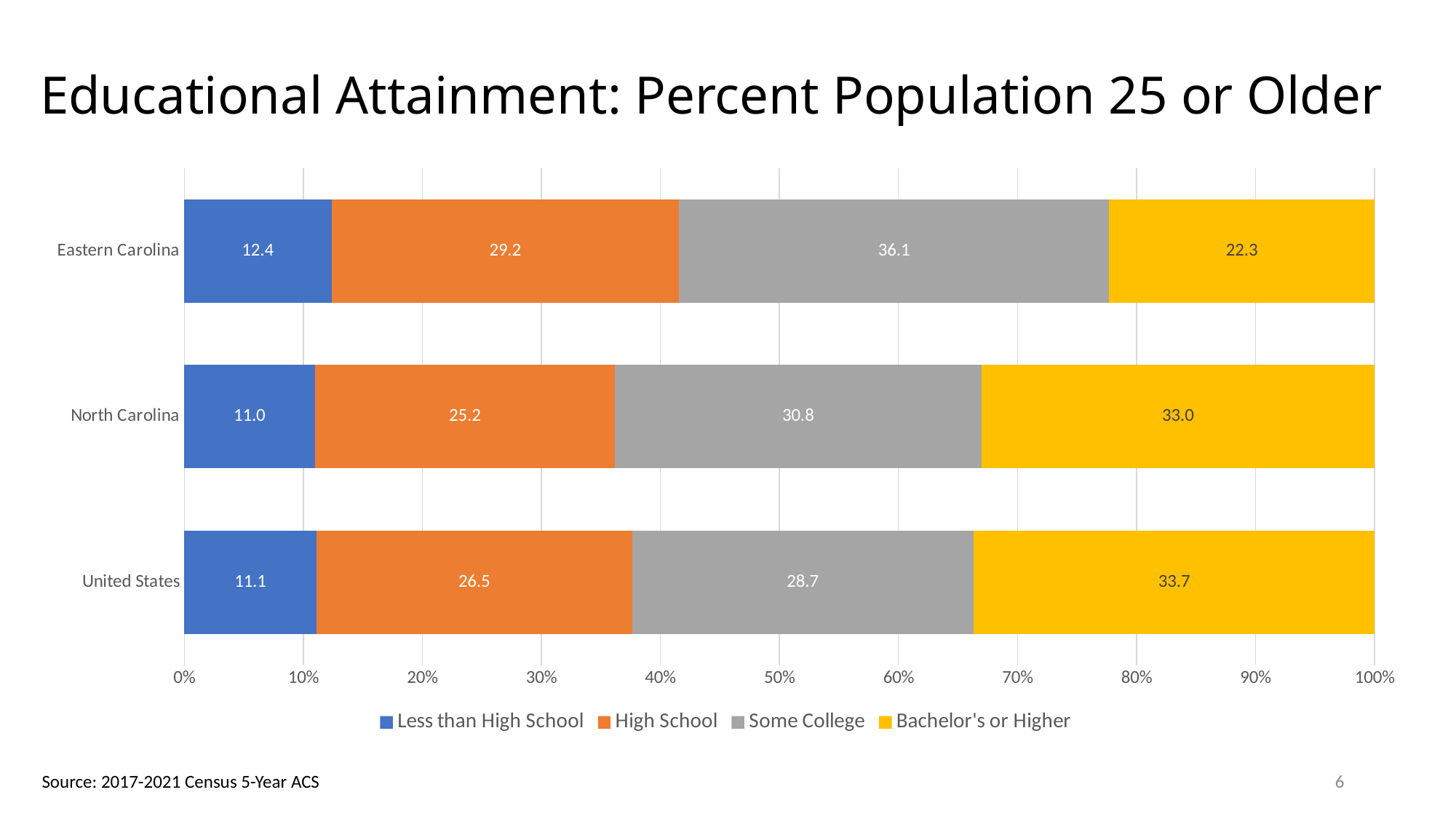
Which region has the lowest Less than High School value? North Carolina Which is larger: the Some College value for Eastern Carolina or for the United States? Eastern Carolina What is the High School value for the United States? 26.5 What kind of chart is shown on the slide? Stacked bar chart What is the difference between the Bachelor's or Higher values for the United States and Eastern Carolina? 11.4 What is the total of the stacked bar for North Carolina? 100.0 How many series does the legend list? 4 What is the Bachelor's or Higher value for North Carolina? 33.0 What is the Some College value for Eastern Carolina? 36.1 What is the title of the chart? Educational Attainment: Percent Population 25 or Older How many regions are shown on the chart? 3 Which region has the highest Bachelor's or Higher value? United States